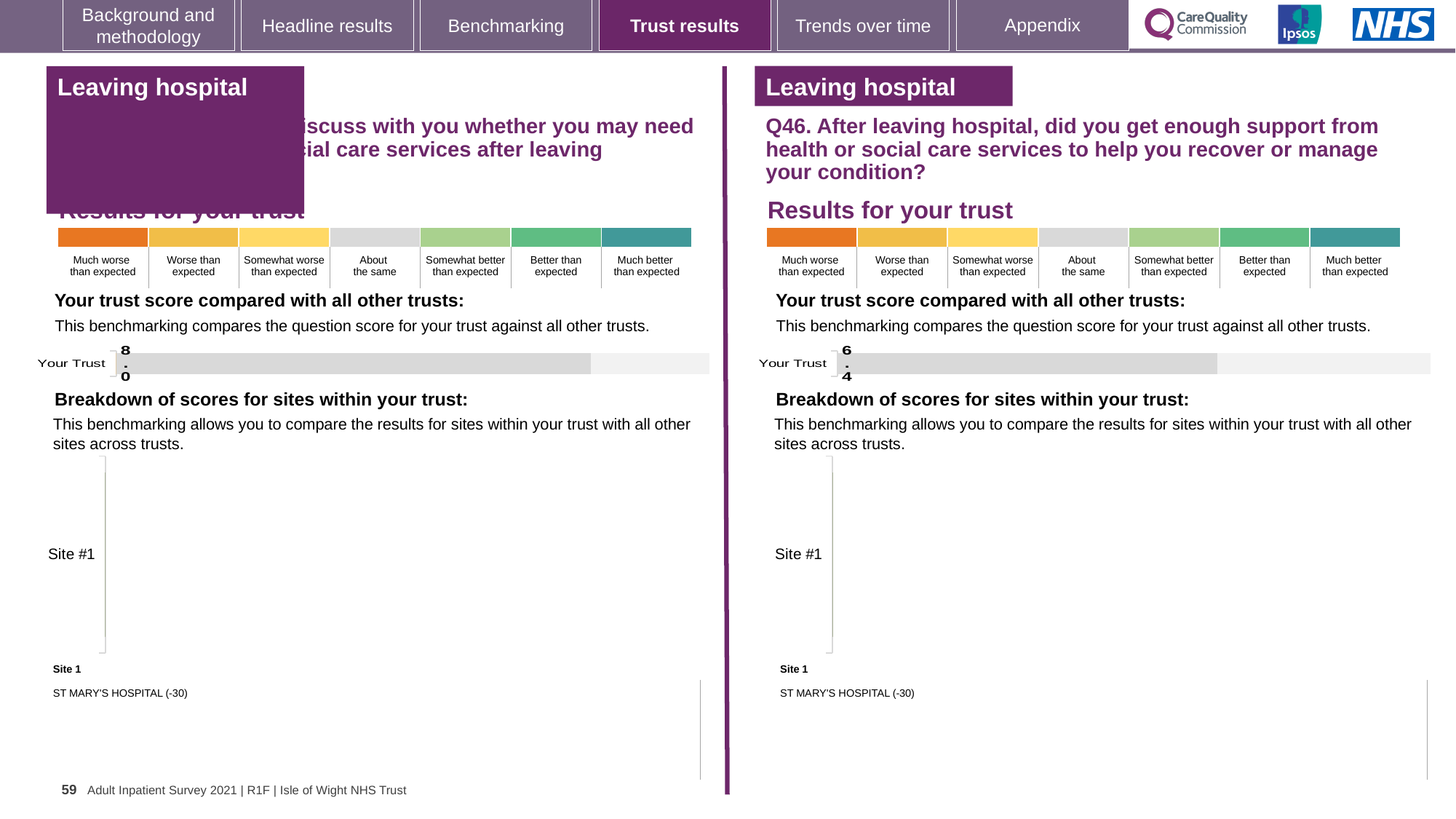
On the right chart (Q46), what is the score shown for Your Trust? 6.4 What is the difference between the Your Trust score on the left chart and the Your Trust score on the right chart (Q46)? 1.6 On the right chart (Q46), is the Your Trust score greater or less than 7? less What is the label of the single category in the trust score chart on the right side of the slide? Your Trust On the left chart, is the Your Trust score greater or less than 7? greater What kind of chart is used to show the Your Trust score on the right chart (Q46)? bar chart Which chart shows the higher Your Trust score, the left chart or the right chart (Q46)? the left chart How many categories are plotted in the Your Trust score chart on the left side of the slide? 1 In the site breakdown chart on the right side of the slide, which site is listed as Site 1? ST MARY'S HOSPITAL (-30) On the left chart, what is the score shown for Your Trust? 8.0